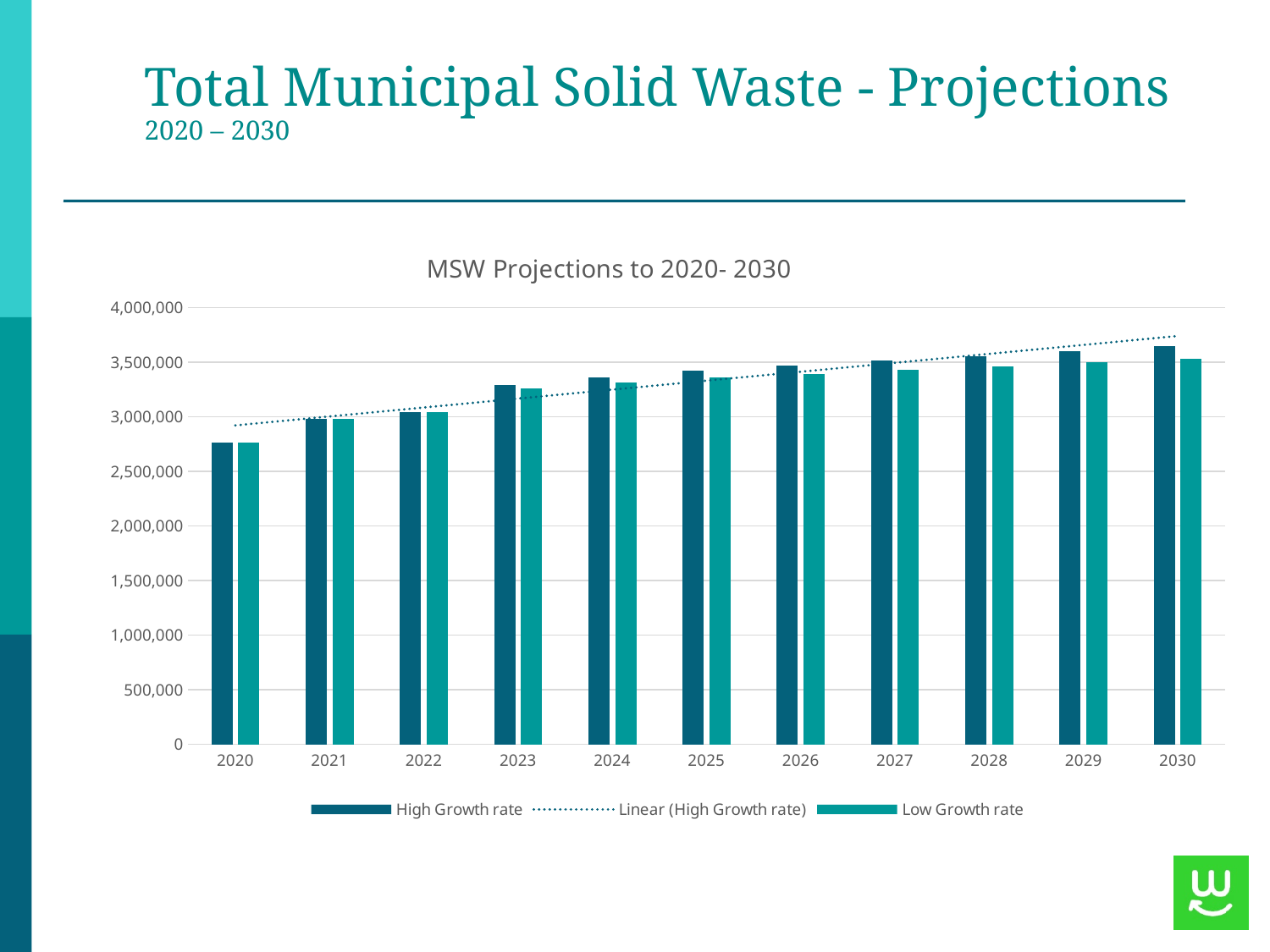
What kind of chart is shown on the slide? bar chart Which legend entry is drawn as a dotted line? Linear (High Growth rate) Is the High Growth rate value for 2030 greater or less than 3,500,000? greater Which year has the lowest Low Growth rate value? 2020 How many years are shown on the x axis? 11 In 2030, which is larger: the High Growth rate value or the Low Growth rate value? High Growth rate Is the High Growth rate value for 2020 greater or less than 3,000,000? less How many series does the legend list? 3 What is the title of the chart? MSW Projections to 2020- 2030 Is the Low Growth rate value for 2025 greater or less than 3,000,000? greater Do the High Growth rate values rise or fall from 2020 to 2030? rise Which year has the highest High Growth rate value? 2030